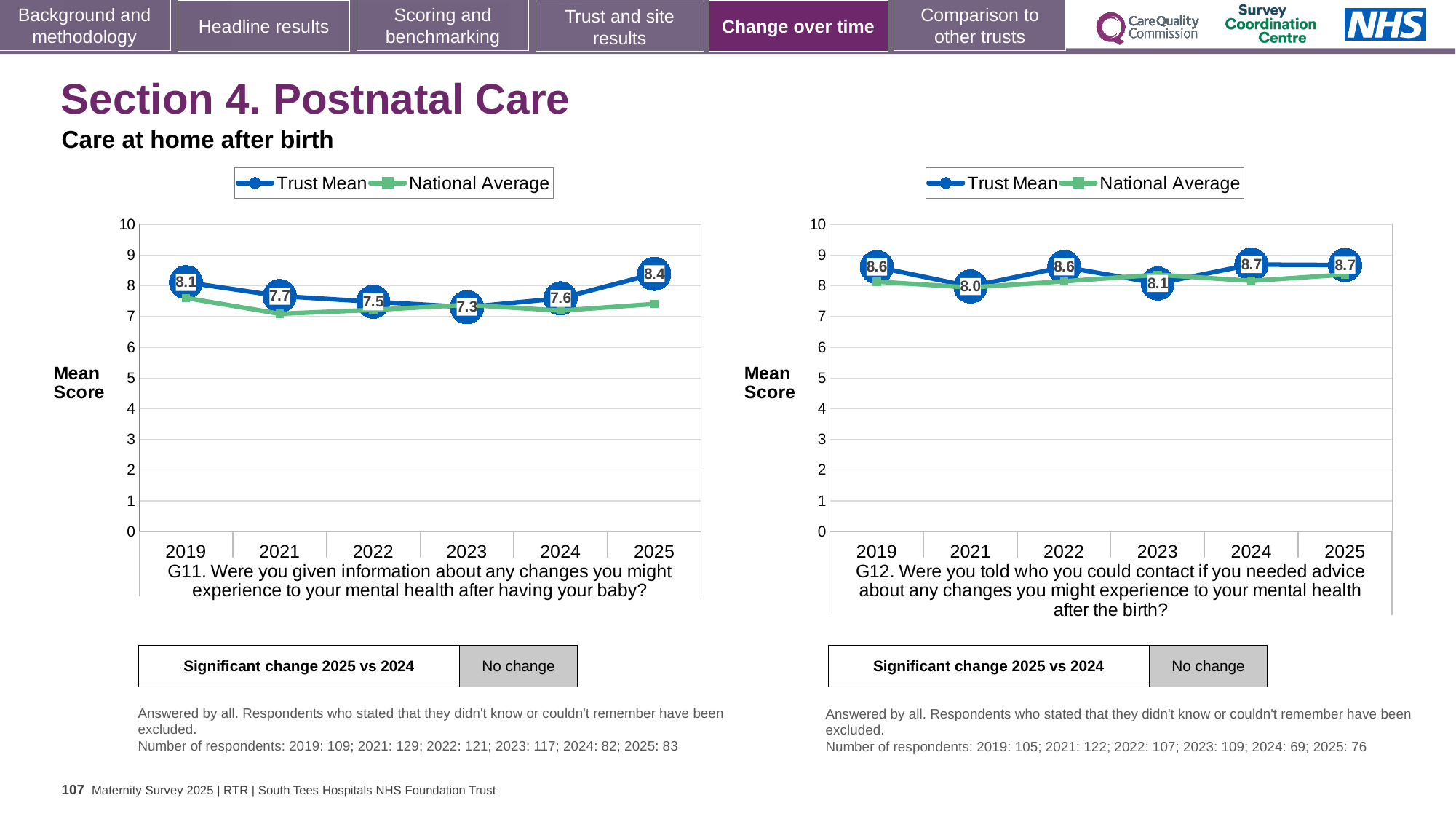
In the G11 chart (left), is the National Average value for 2021 greater or less than 8? less In the G12 chart (right), what is the Trust Mean score for 2021? 8.0 In the G12 chart (right), is the Trust Mean score higher in 2019 or in 2023? 2019 In the G11 chart (left), what is the Trust Mean score for 2023? 7.3 How many years are shown on the x axis of the G12 chart (right)? 6 How many series does the legend of the G11 chart (left) list? 2 In the G11 chart (left), what is the difference between the Trust Mean scores for 2025 and 2024? 0.8 In the G11 chart (left), what is the Trust Mean score for 2025? 8.4 What type of chart is the G12 chart (right)? Line chart In the G11 chart (left), which year has the highest Trust Mean score? 2025 In the G11 chart (left), which year has the lowest Trust Mean score? 2023 In the G12 chart (right), which year has the lowest Trust Mean score? 2021